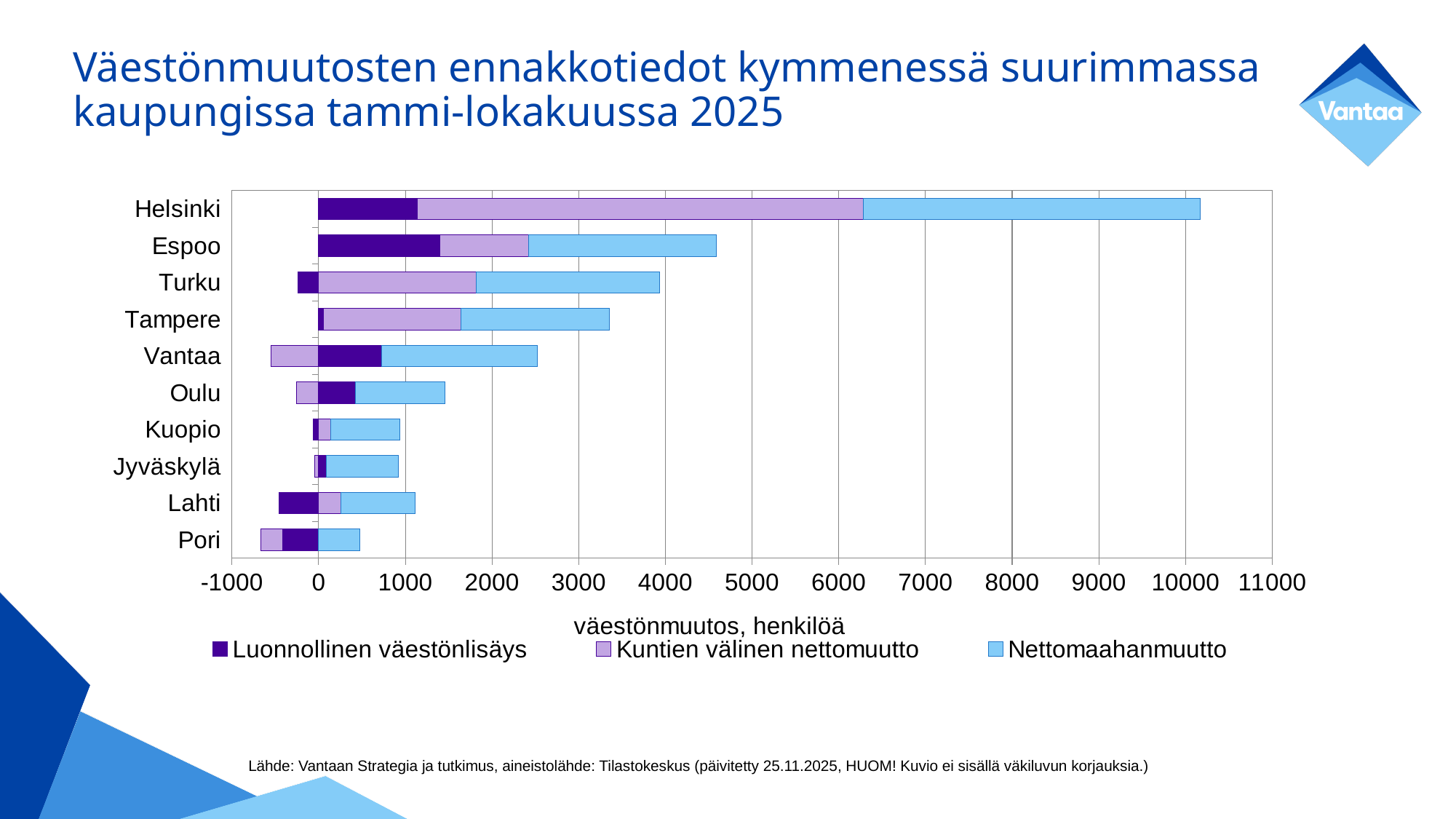
Is the Luonnollinen väestönlisäys value for Lahti positive or negative? negative Which city has the largest Nettomaahanmuutto segment? Helsinki Which city has the longest total bar in the chart? Helsinki What is the label of the horizontal axis of the chart? väestönmuutos, henkilöä How many cities are listed on the vertical axis of the chart? 10 What kind of chart is shown on the slide? Stacked bar chart Is the total bar length for Helsinki greater or less than 10000? greater Which city has the larger total bar, Espoo or Tampere? Espoo How many series does the chart legend list? 3 Is the total bar length for Espoo greater or less than 4000? greater